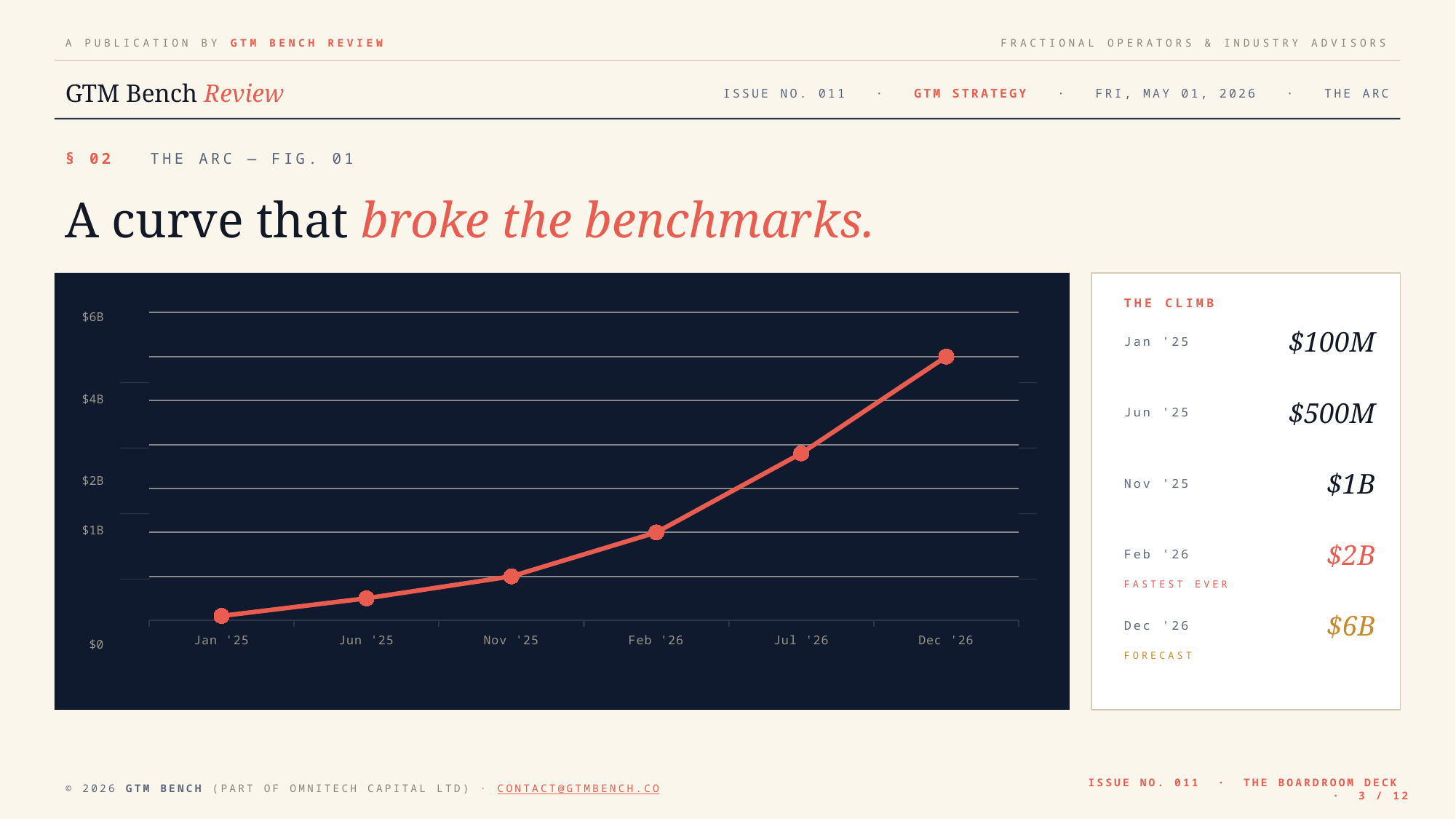
Is the plotted value for Jul '26 greater or less than $2B? greater Which x-axis category has the lowest plotted value? Jan '25 Which x-axis category has the highest plotted value? Dec '26 According to the 'THE CLIMB' panel, what is the value for Jan '25? $100M Do the plotted values rise or fall from Jan '25 to Dec '26? rise What kind of chart is shown on the slide? line chart What is the headline title above the chart? A curve that broke the benchmarks. According to the 'THE CLIMB' panel, what is the forecast value for Dec '26? $6B Is the plotted value for Dec '26 greater or less than $4B? greater How many data points are plotted on the line chart? 6 Is the plotted value for Jul '26 larger or smaller than the value for Feb '26? larger